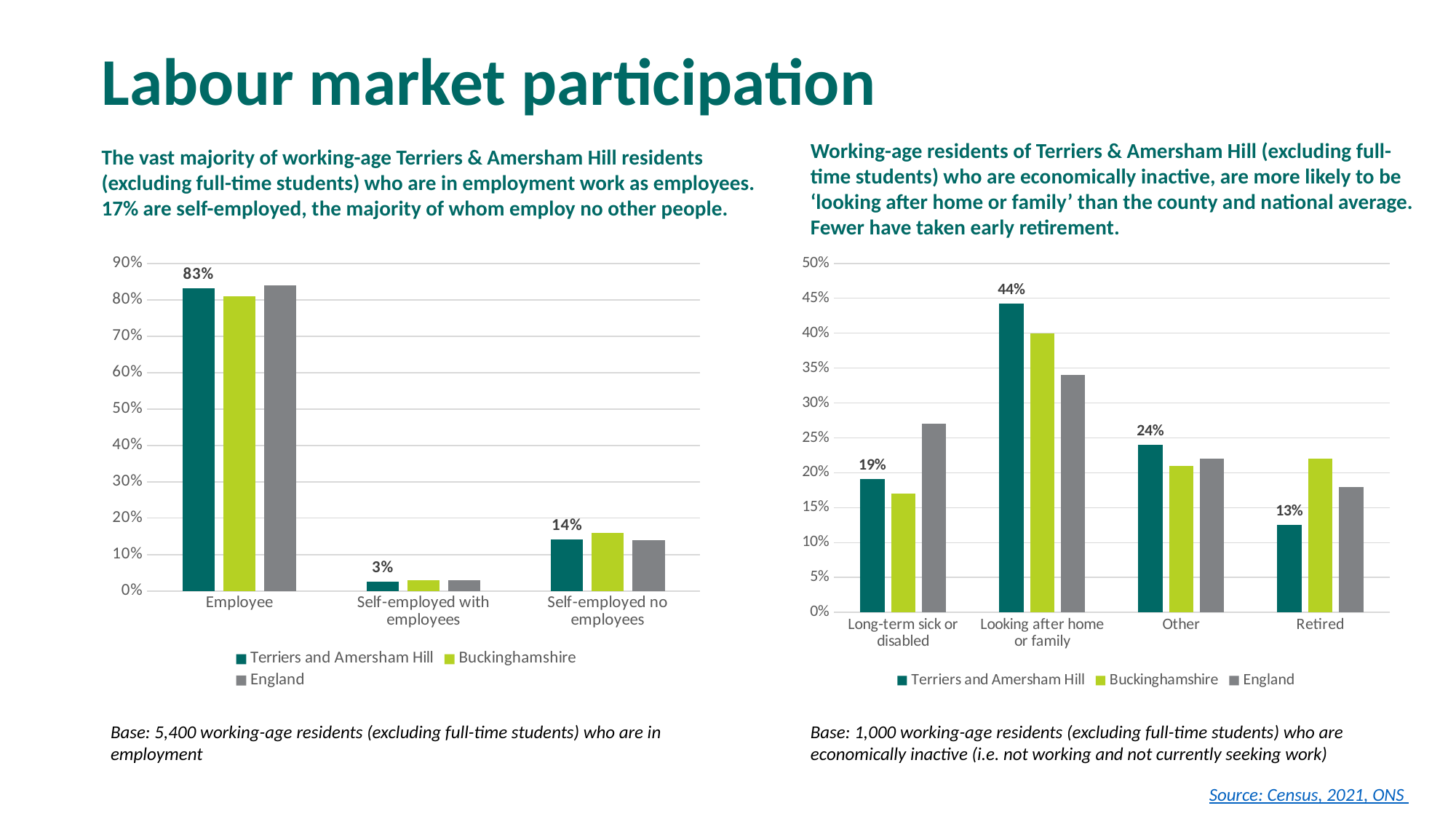
In the right chart, which category has the highest value for Terriers and Amersham Hill? Looking after home or family In the left chart, is the England value for Employee greater or less than 80%? greater In the left chart, what is the difference between the Terriers and Amersham Hill values for Employee and 'Self-employed no employees'? 69% In the right chart, for Retired, which is larger: the Buckinghamshire value or the Terriers and Amersham Hill value? Buckinghamshire In the right chart, what is the value for Terriers and Amersham Hill for 'Looking after home or family'? 44% What type of chart is the right chart? Bar chart In the right chart, how many categories are shown on the x axis? 4 In the right chart, what is the value for Terriers and Amersham Hill for Retired? 13% In the left chart, what is the value for Terriers and Amersham Hill for 'Self-employed no employees'? 14% In the left chart, which category has the lowest value for Terriers and Amersham Hill? Self-employed with employees In the left chart, how many series does the legend list? 3 In the left chart, what is the value for Terriers and Amersham Hill in the Employee category? 83%